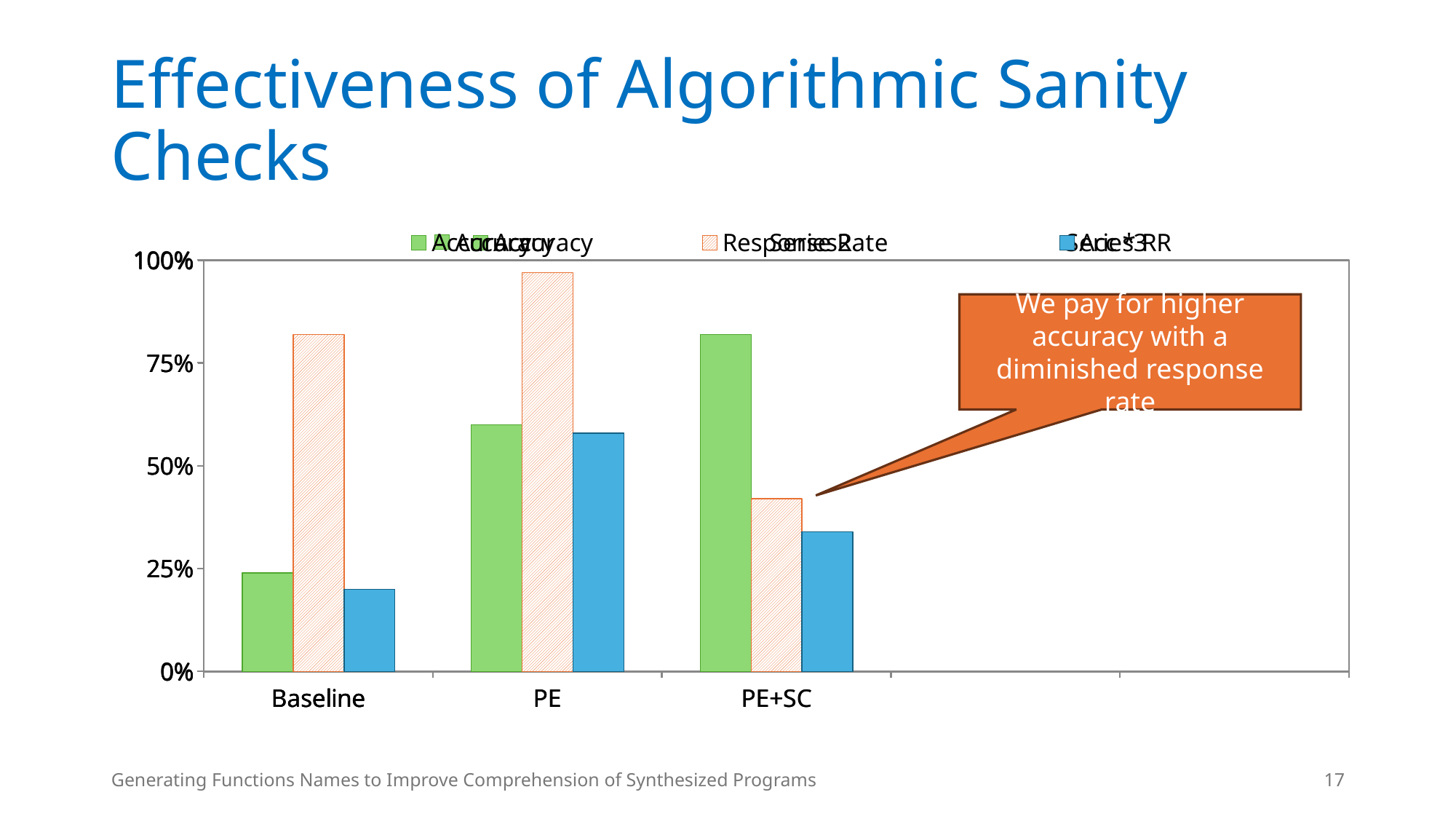
Is the value of the green bar for Baseline greater or less than 50%? less Which category has the shortest blue bar? Baseline For PE+SC, which is larger: the green bar or the orange hatched bar? the green bar Is the value of the blue bar for PE+SC greater or less than 50%? less What kind of chart is shown on the slide? bar chart Which category has the tallest green bar? PE+SC Is the value of the green bar for PE greater or less than 50%? greater Do the green bars rise or fall from Baseline to PE+SC? rise How many series does the chart's legend list? 3 How many categories are shown on the x axis of the chart? 3 Which category has the tallest orange hatched bar? PE